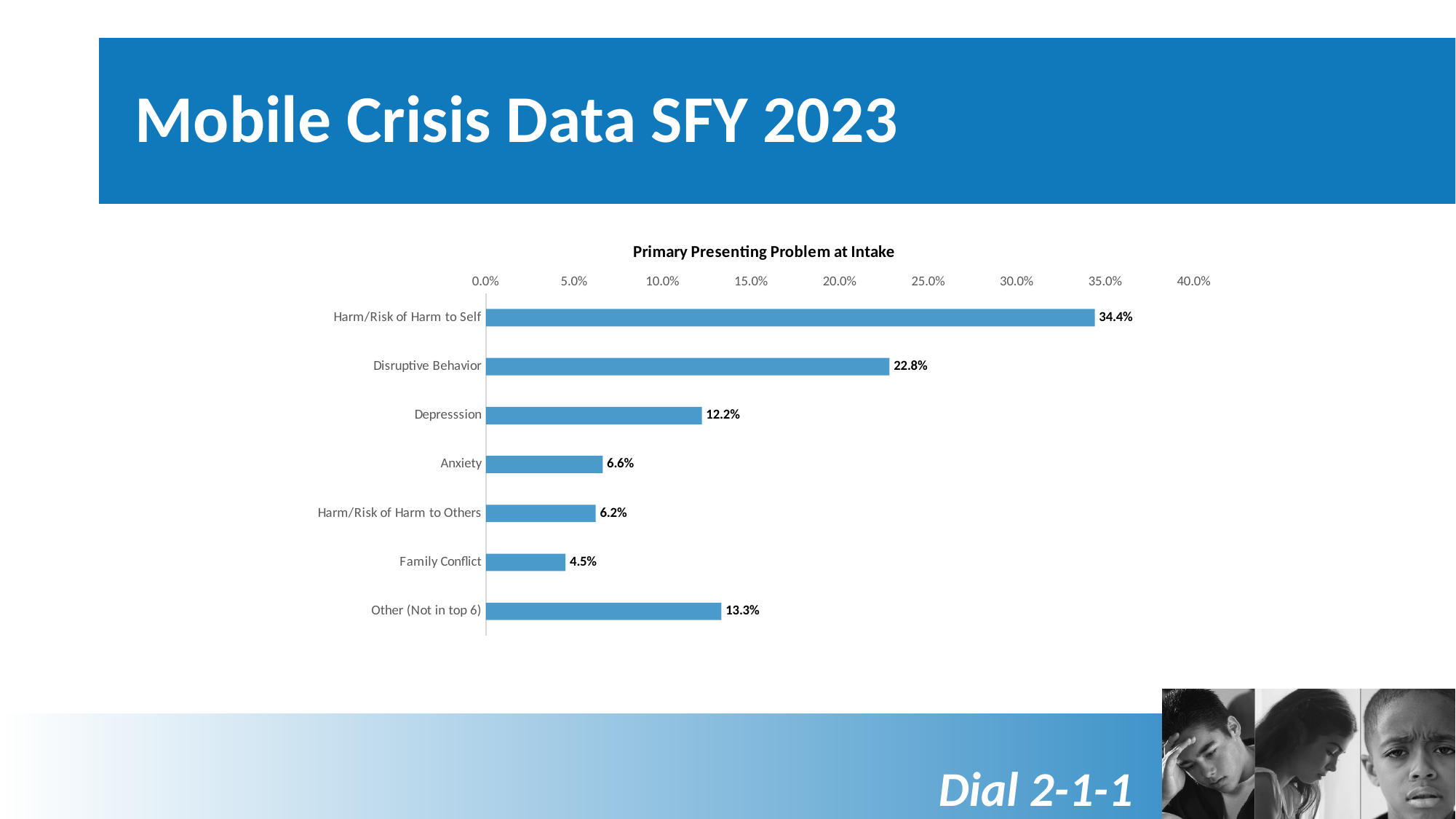
What is the value for Disruptive Behavior? 22.8% What is the value for Harm/Risk of Harm to Self? 34.4% What kind of chart is shown on the slide? Bar chart What is the value for Other (Not in top 6)? 13.3% What is the value for Family Conflict? 4.5% Which category has the lowest value? Family Conflict Is the value for Disruptive Behavior greater or less than 20.0%? greater Which category has the highest value? Harm/Risk of Harm to Self What is the title of the chart? Primary Presenting Problem at Intake What is the difference between Harm/Risk of Harm to Self and Disruptive Behavior? 11.6% How many categories are shown in the chart? 7 Which is larger, Depresssion or Other (Not in top 6)? Other (Not in top 6)